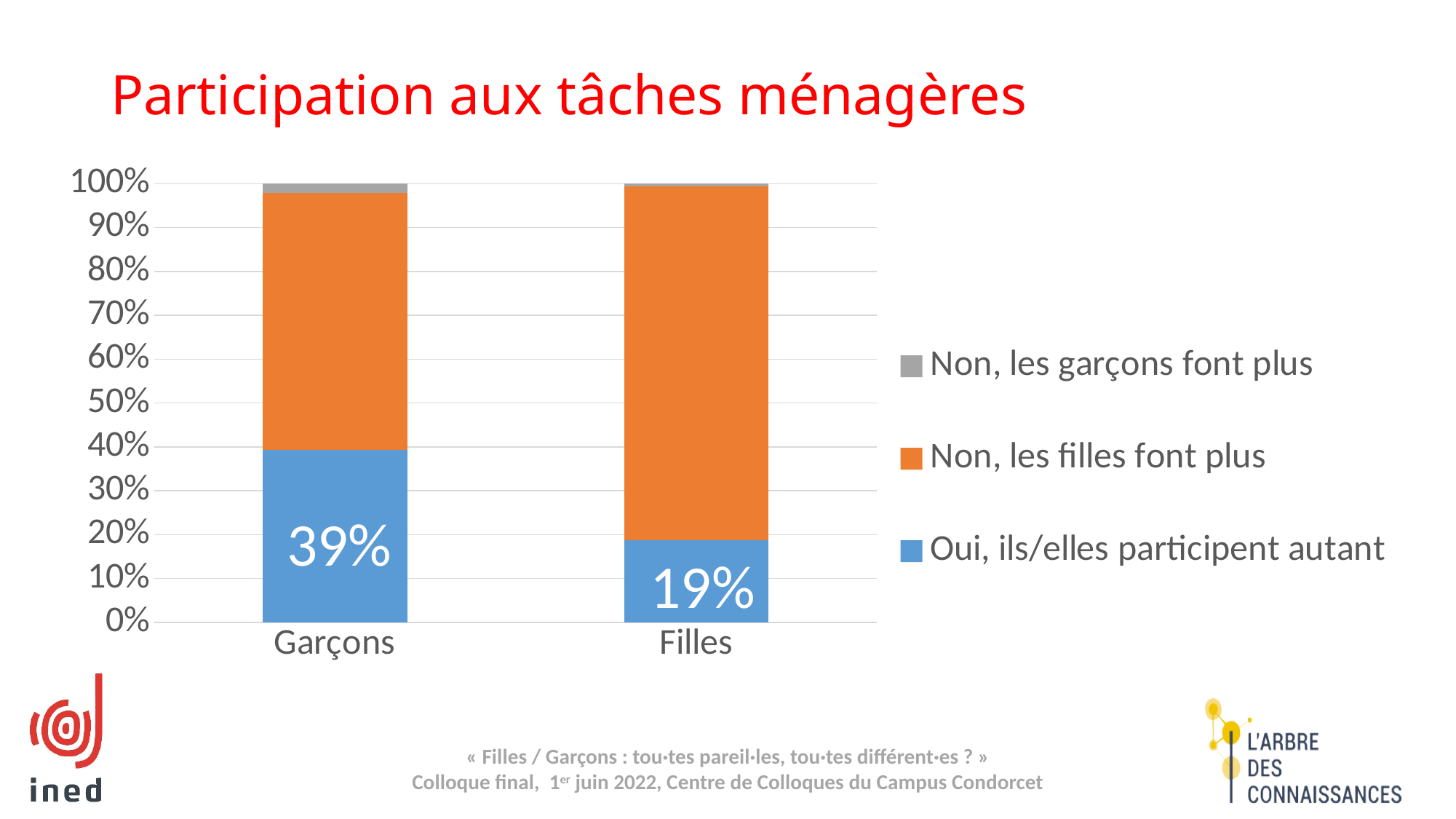
How many series does the legend list? 3 Which is larger for "Oui, ils/elles participent autant": Garçons or Filles? Garçons What is the value for Garçons in the series "Oui, ils/elles participent autant"? 39% Which category has the lowest value for "Oui, ils/elles participent autant"? Filles How many categories are shown on the x axis? 2 What is the difference between the Garçons and Filles values for "Oui, ils/elles participent autant"? 20 percentage points What is the value for Filles in the series "Oui, ils/elles participent autant"? 19% Is the value for Garçons in the series "Non, les garçons font plus" greater or less than 10%? less Which category has the highest value for "Oui, ils/elles participent autant"? Garçons What is the title of the slide? Participation aux tâches ménagères Is the value for Filles in the series "Non, les filles font plus" greater or less than 70%? greater What kind of chart is shown on the slide? Stacked bar chart